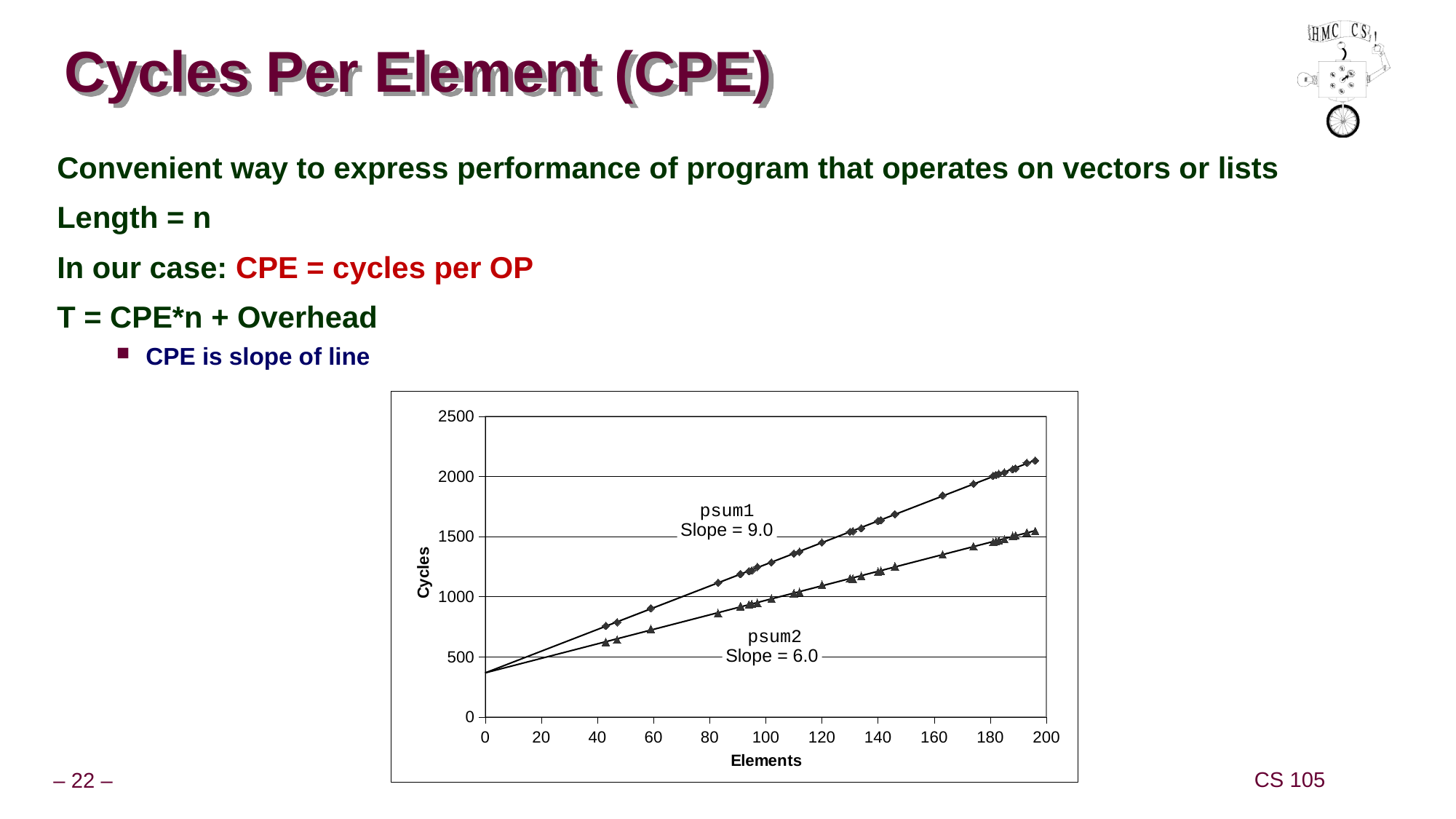
What is the label on the y axis of the chart? Cycles Is the psum2 value at about 195 elements greater or less than 2000 cycles? less Do the cycle counts rise or fall as the number of elements increases? rise Is the psum1 value at about 195 elements greater or less than 2000 cycles? greater What is the label on the x axis of the chart? Elements What is the difference between the printed slopes of psum1 and psum2? 3.0 What is the slope printed for the psum2 series? 6.0 What is the slope printed for the psum1 series? 9.0 How many data series are plotted on the chart? 2 At 160 elements, which series has more cycles, psum1 or psum2? psum1 Which series has the larger slope, psum1 or psum2? psum1 What kind of chart is shown on the slide? scatter plot